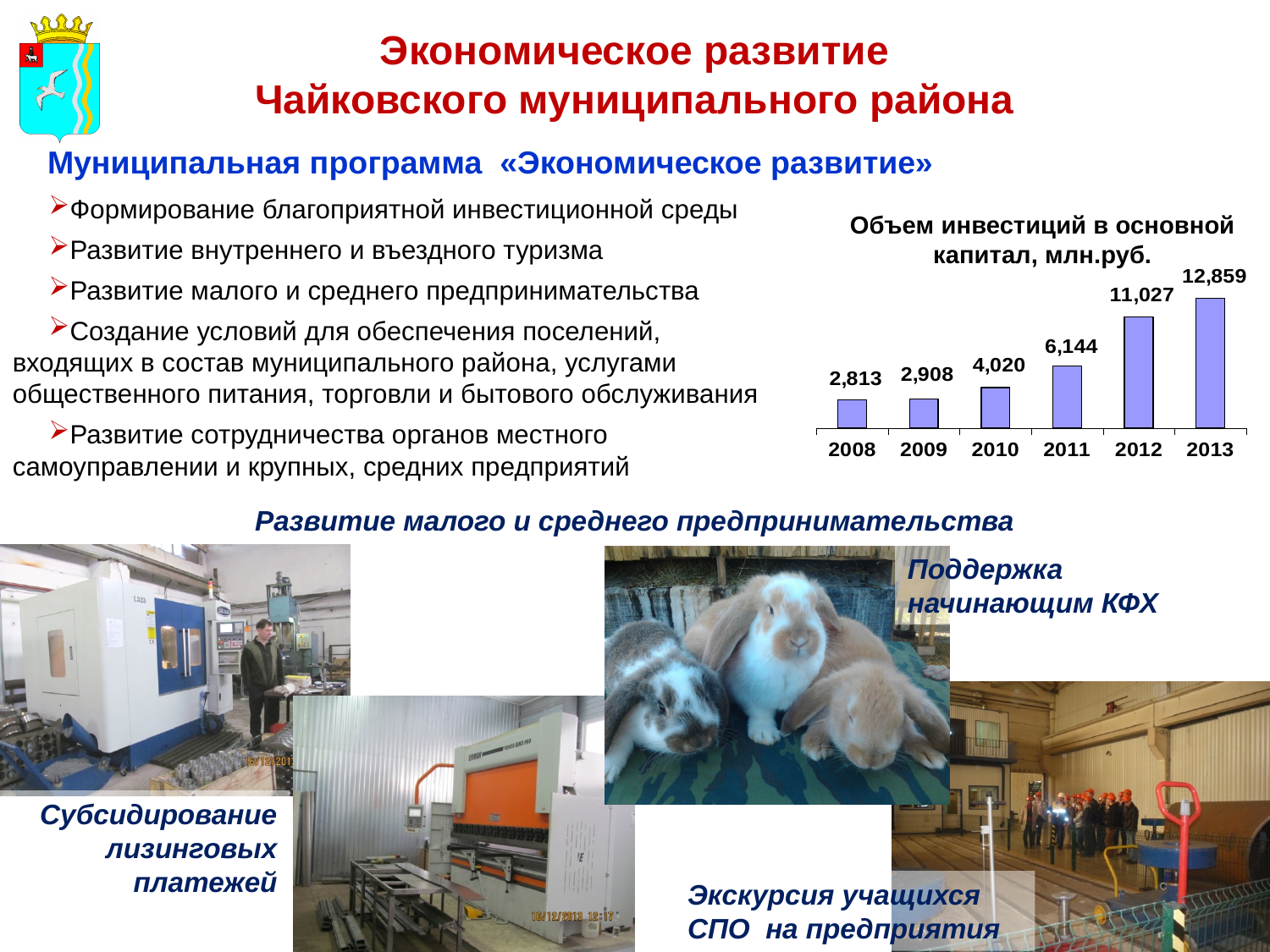
Do the values in the chart 'Объем инвестиций в основной капитал, млн.руб.' rise or fall from 2008 to 2013? rise How many years are shown in the chart 'Объем инвестиций в основной капитал, млн.руб.'? 6 What is the value for 2011 in the chart 'Объем инвестиций в основной капитал, млн.руб.'? 6,144 What is the value for 2013 in the chart 'Объем инвестиций в основной капитал, млн.руб.'? 12,859 Which year has the lowest value in the chart 'Объем инвестиций в основной капитал, млн.руб.'? 2008 What kind of chart is 'Объем инвестиций в основной капитал, млн.руб.'? bar chart What is the difference between the values for 2013 and 2012 in the chart 'Объем инвестиций в основной капитал, млн.руб.'? 1,832 In the chart 'Объем инвестиций в основной капитал, млн.руб.', which is larger: the value for 2010 or the value for 2012? 2012 Which year has the highest value in the chart 'Объем инвестиций в основной капитал, млн.руб.'? 2013 What unit is given in the title of the chart on the slide? млн.руб. What is the value for 2008 in the chart 'Объем инвестиций в основной капитал, млн.руб.'? 2,813 What is the difference between the values for 2011 and 2010 in the chart 'Объем инвестиций в основной капитал, млн.руб.'? 2,124